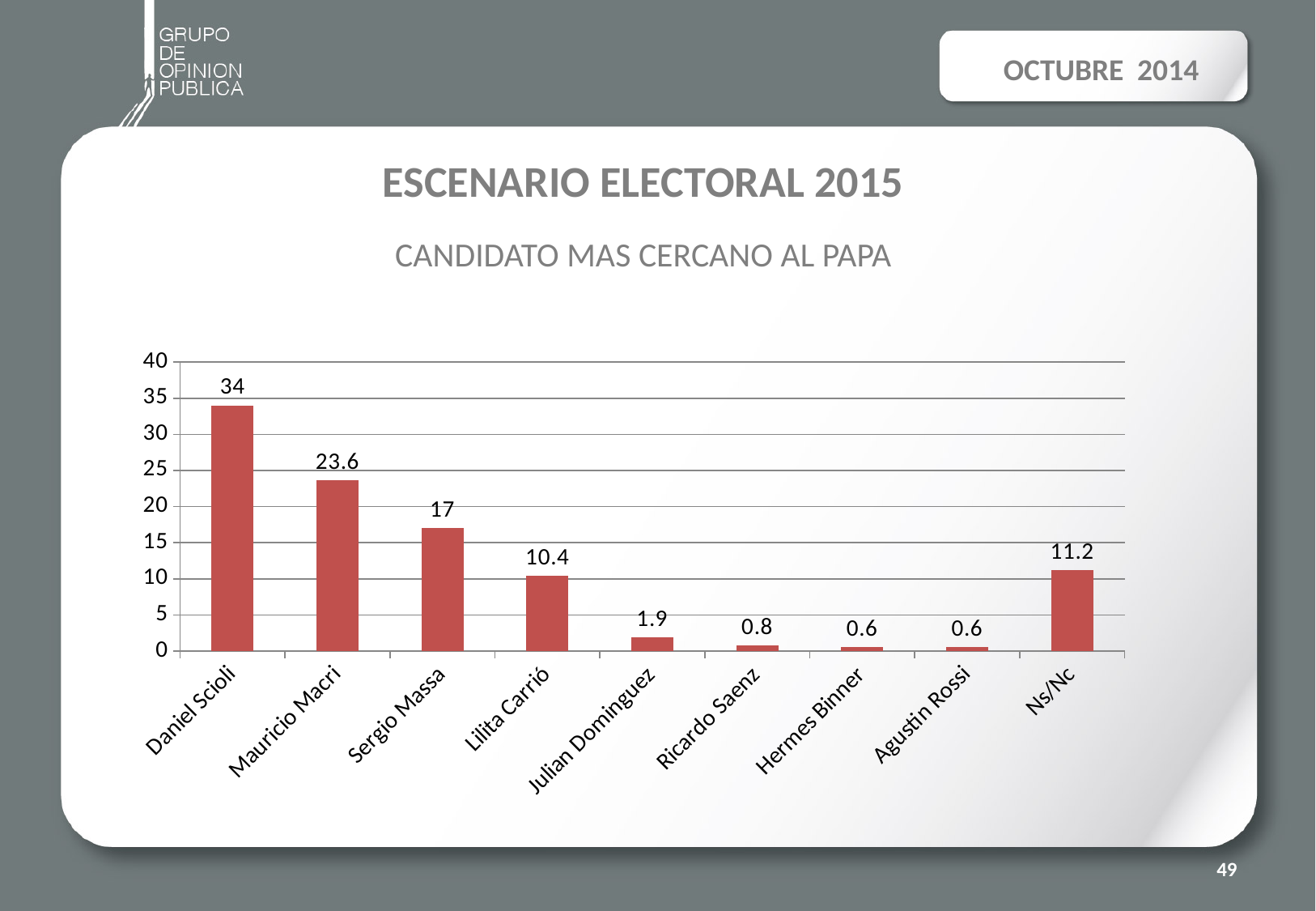
Which is larger, the value for Lilita Carrió or the value for Ns/Nc? Ns/Nc What is the difference between the values for Daniel Scioli and Mauricio Macri? 10.4 How many categories are shown on the x axis? 9 What is the value for Daniel Scioli? 34 What is the value for Mauricio Macri? 23.6 Which category has the highest value? Daniel Scioli What is the value for Ns/Nc? 11.2 What is the difference between the values for Sergio Massa and Lilita Carrió? 6.6 Is the value for Sergio Massa greater or less than 20? less What is the subtitle of the chart? CANDIDATO MAS CERCANO AL PAPA What is the value for Julian Dominguez? 1.9 What kind of chart is shown on the slide? bar chart